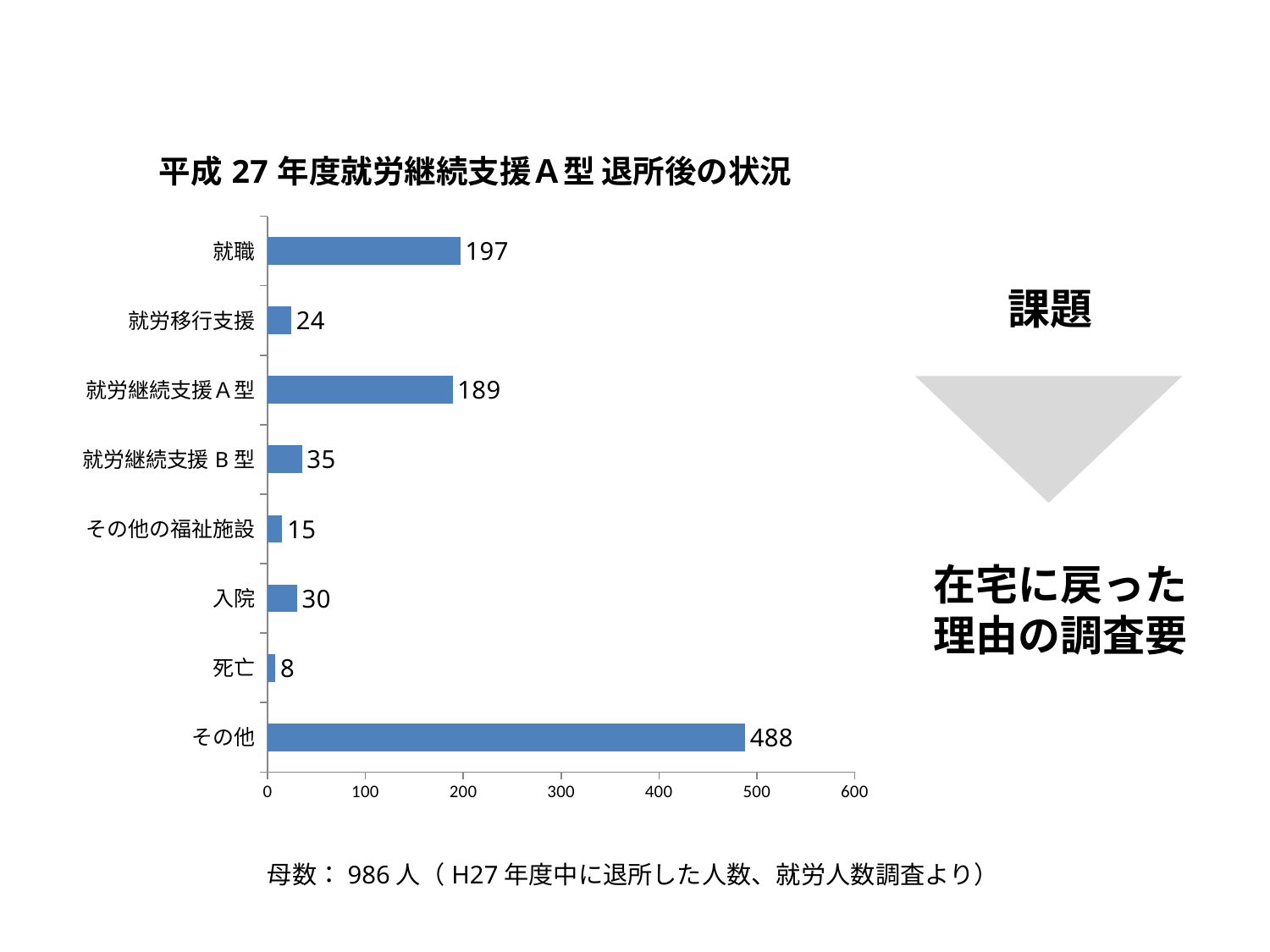
Which category has the highest value? その他 What is the value for 就労継続支援Ｂ型? 35 What is the difference between the values for 就職 and 就労継続支援Ａ型? 8 Is the value for その他 greater or less than 400? greater What kind of chart is shown on the slide? bar chart What is the value for その他? 488 Which category has the lowest value? 死亡 Which is larger, the value for 入院 or the value for その他の福祉施設? 入院 How many categories are shown in the chart? 8 What is the value for 死亡? 8 What is the title of the chart? 平成27年度就労継続支援Ａ型 退所後の状況 What is the value for 就職? 197